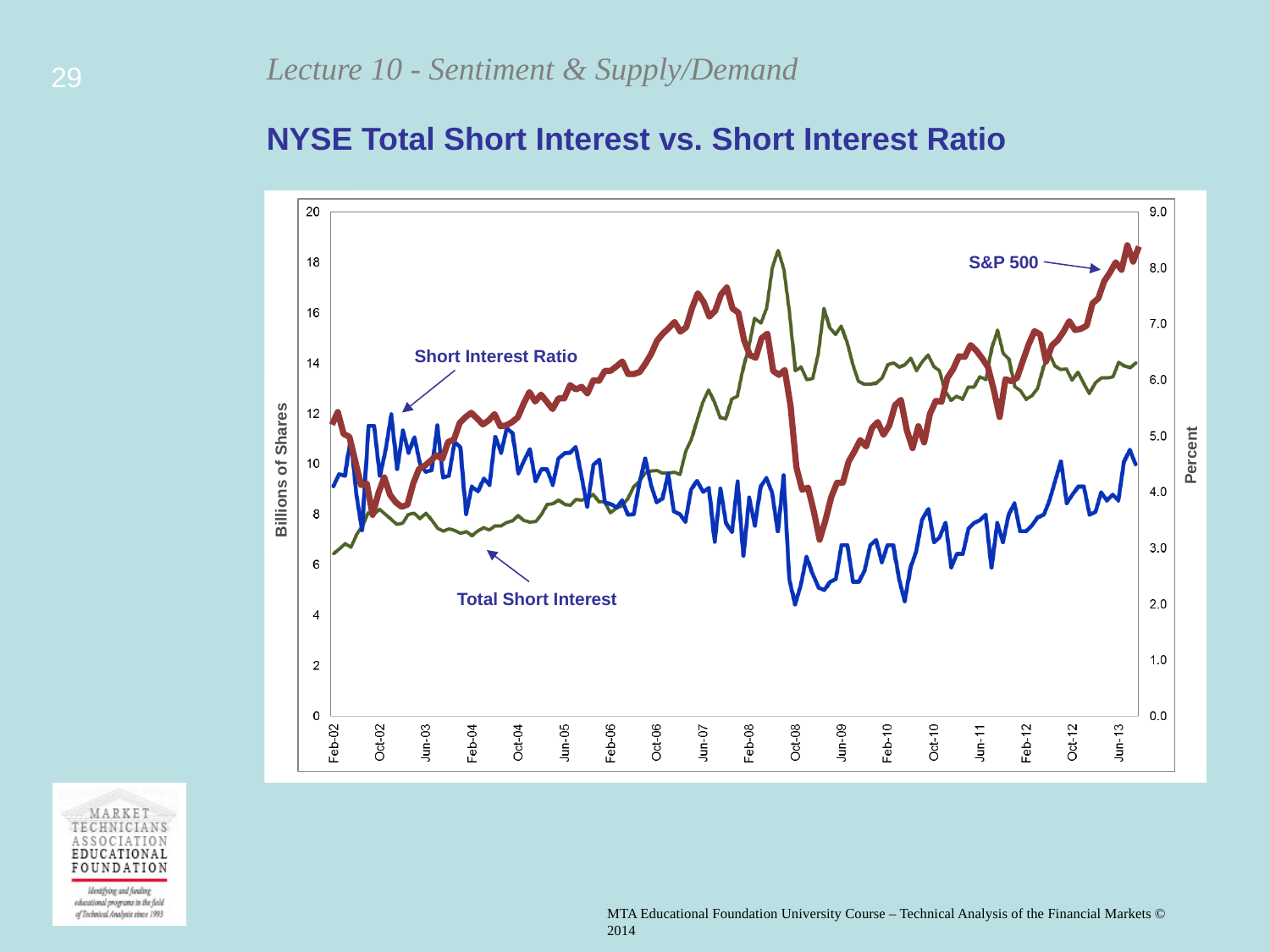
Does the S&P 500 line rise or fall between Oct-08 and Jun-13? rise Is the Total Short Interest value at Oct-08 greater or less than 6 billion shares? less Is the Total Short Interest value at Jun-13 greater or less than 8 billion shares? greater What is the title of the chart on the slide? NYSE Total Short Interest vs. Short Interest Ratio Does the Total Short Interest line generally rise or fall between Feb-02 and Oct-08? fall What is the last date label on the x axis of the chart? Jun-13 How many data series are plotted on the chart? 3 What is the first date label on the x axis of the chart? Feb-02 What is the label on the left vertical axis of the chart? Billions of Shares What kind of chart is shown on the slide? Line chart Does the Short Interest Ratio line generally rise or fall between Feb-02 and Feb-08? rise